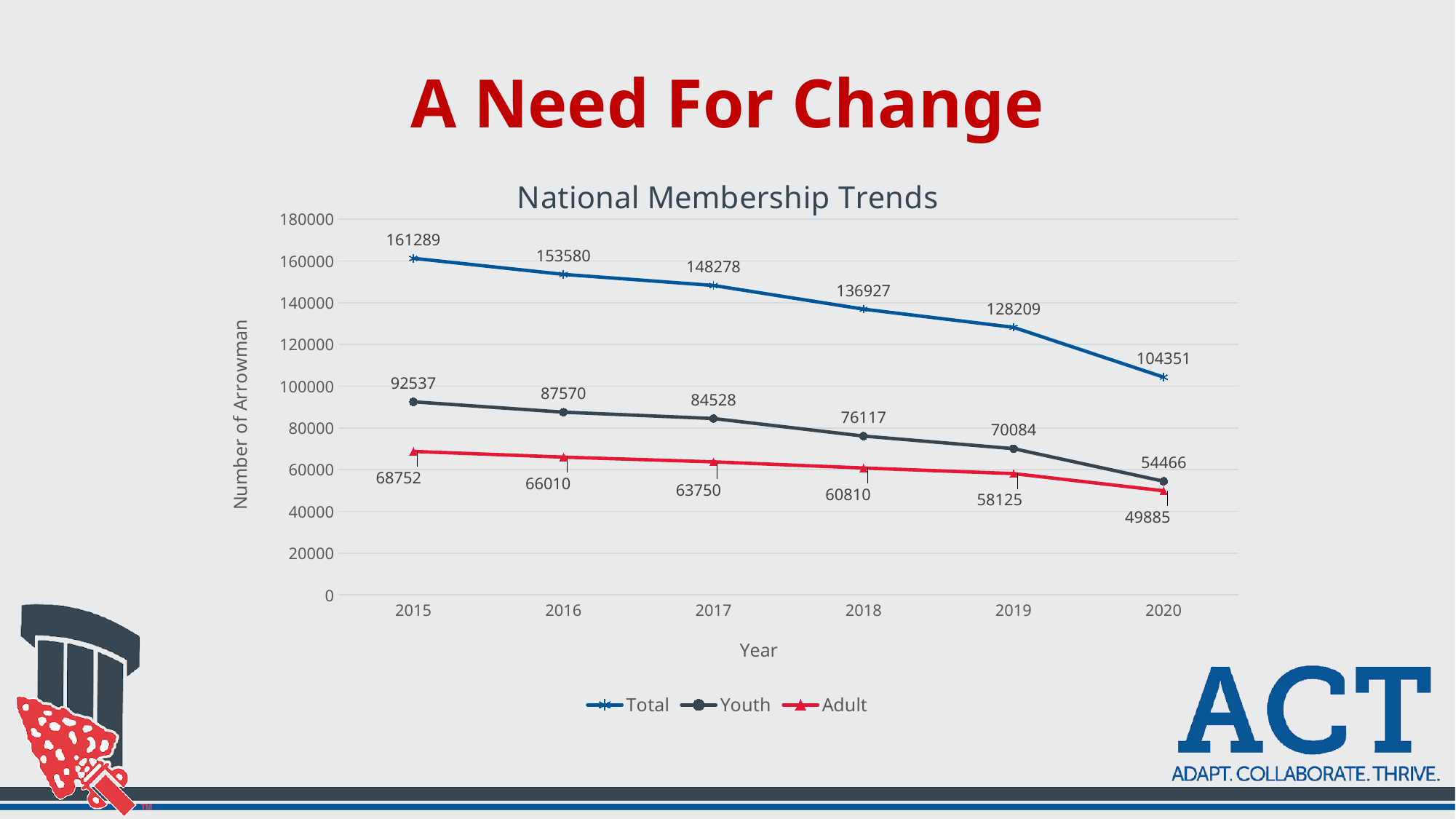
How many series does the legend list? 3 Is the Total membership value for 2019 greater or less than 120000? greater How many years are shown on the x axis? 6 What is the difference between the Total membership in 2015 and in 2020? 56938 What is the Youth membership value for 2018? 76117 Do the Adult membership values rise or fall from 2015 to 2020? fall What is the Adult membership value for 2020? 49885 In which year is the Youth membership highest? 2015 Which is larger, the Youth value in 2019 or the Adult value in 2019? Youth What is the Total membership value for 2015? 161289 In which year is the Total membership lowest? 2020 What kind of chart is shown on the slide? line chart